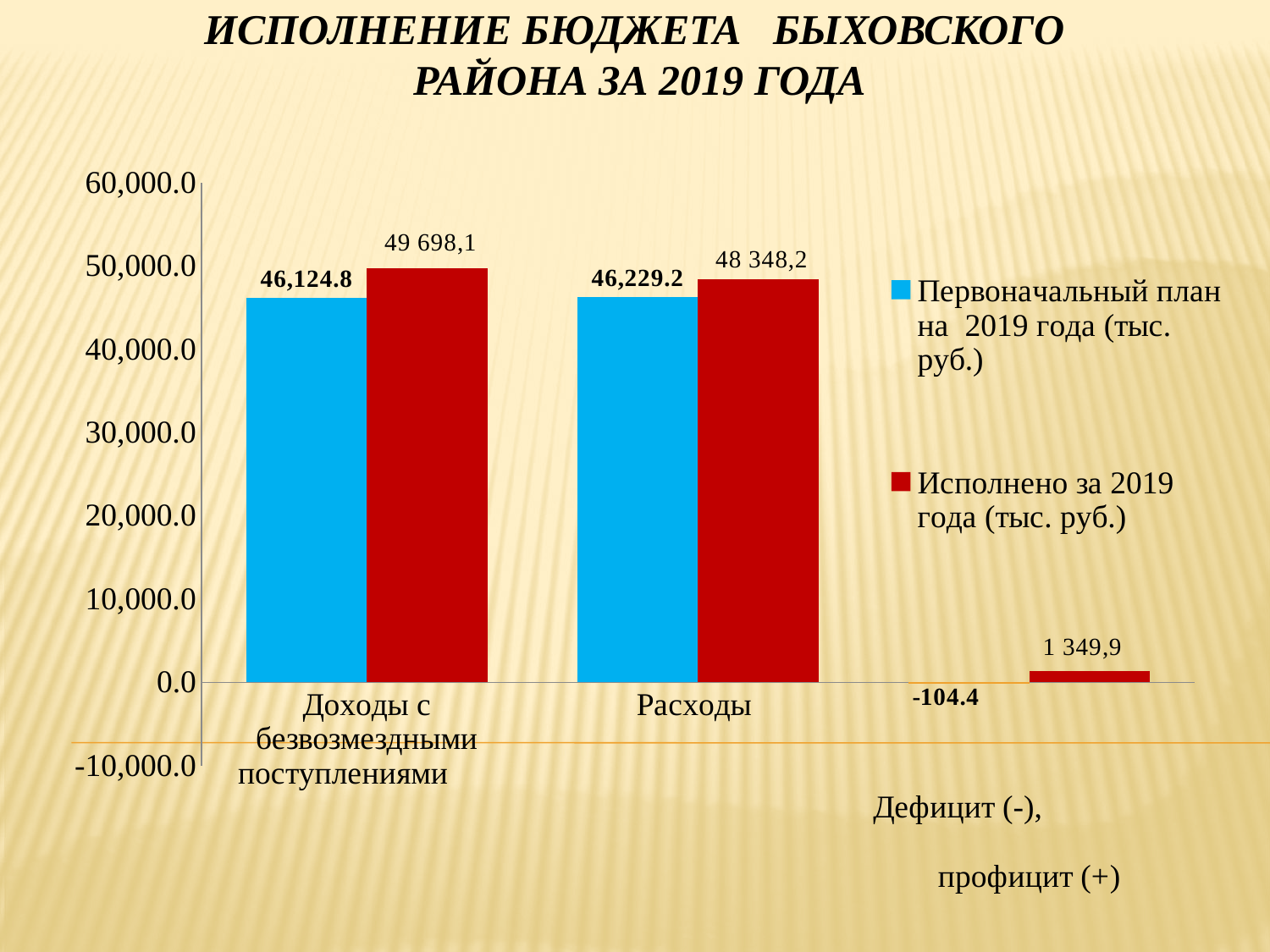
What is the value of 'Первоначальный план на 2019 года (тыс. руб.)' for 'Дефицит (-), профицит (+)'? -104.4 How many series does the legend list? 2 For 'Расходы', which is larger: 'Первоначальный план на 2019 года (тыс. руб.)' or 'Исполнено за 2019 года (тыс. руб.)'? Исполнено за 2019 года (тыс. руб.) What is the value of 'Исполнено за 2019 года (тыс. руб.)' for 'Дефицит (-), профицит (+)'? 1 349,9 How many categories are shown on the x axis? 3 Which category has the highest value in the 'Исполнено за 2019 года (тыс. руб.)' series? Доходы с безвозмездными поступлениями What is the value of 'Исполнено за 2019 года (тыс. руб.)' for 'Расходы'? 48 348,2 What is the value of 'Исполнено за 2019 года (тыс. руб.)' for 'Доходы с безвозмездными поступлениями'? 49 698,1 What is the value of 'Первоначальный план на 2019 года (тыс. руб.)' for 'Расходы'? 46,229.2 What type of chart is shown on the slide? bar chart What colour are the bars for the 'Исполнено за 2019 года (тыс. руб.)' series? red What is the value of 'Первоначальный план на 2019 года (тыс. руб.)' for 'Доходы с безвозмездными поступлениями'? 46,124.8